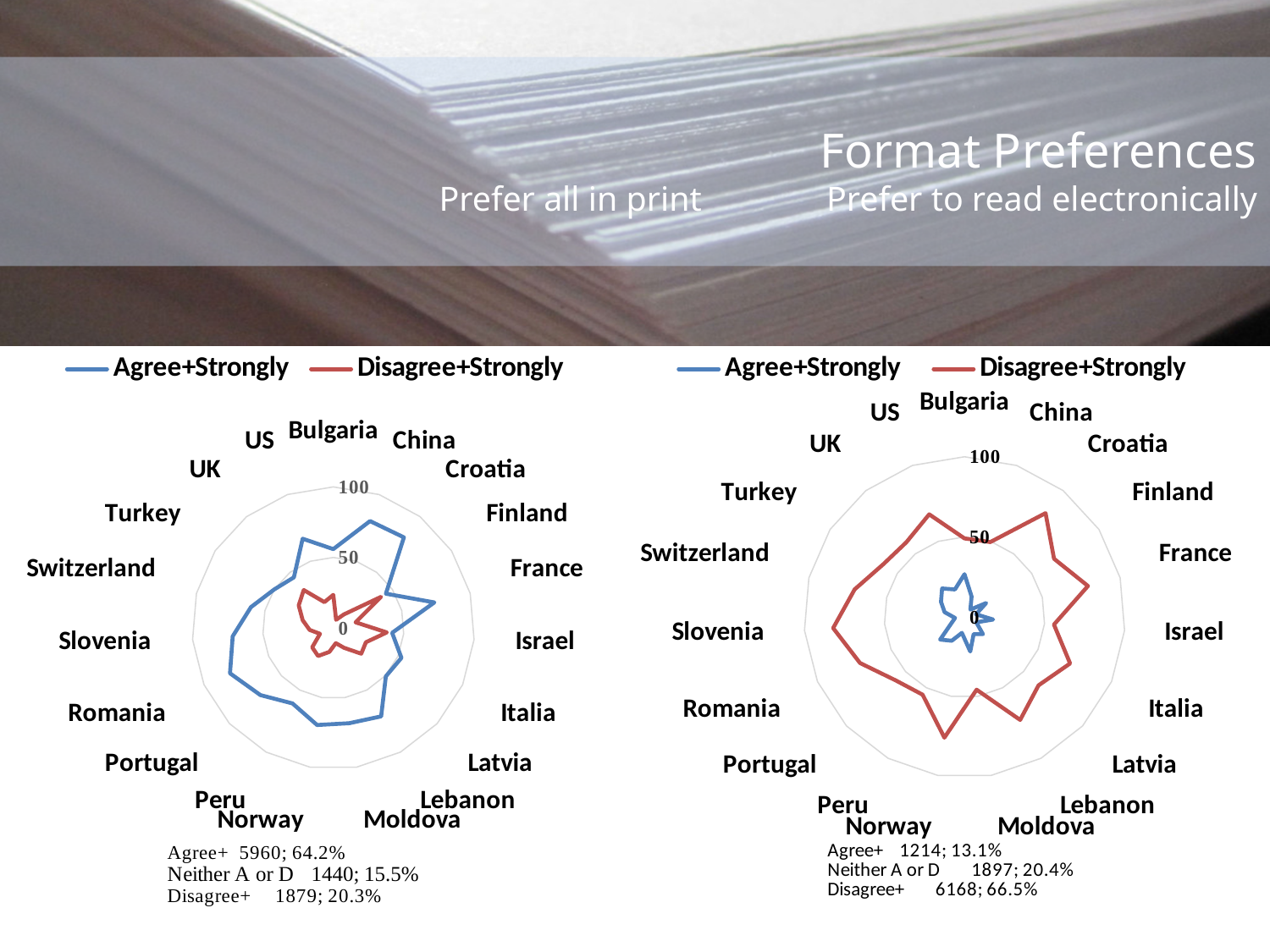
On the 'Prefer all in print' chart, which colour is used for the Agree+Strongly series? blue On the 'Prefer to read electronically' chart, which series has the larger value for Slovenia, Agree+Strongly or Disagree+Strongly? Disagree+Strongly What kind of chart is the 'Prefer all in print' chart on the left? radar chart On the 'Prefer to read electronically' chart, what are the two legend entries? Agree+Strongly and Disagree+Strongly How many countries are plotted on the 'Prefer all in print' chart? 19 On the 'Prefer all in print' chart, is the Disagree+Strongly value for Slovenia greater or less than 50? less On the 'Prefer all in print' chart, which series has the larger value for Slovenia, Agree+Strongly or Disagree+Strongly? Agree+Strongly On the 'Prefer to read electronically' chart, is the Disagree+Strongly value for France greater or less than 50? greater On the 'Prefer to read electronically' chart, is the Disagree+Strongly value for Slovenia greater or less than 50? greater How many series does the legend of the 'Prefer to read electronically' chart list? 2